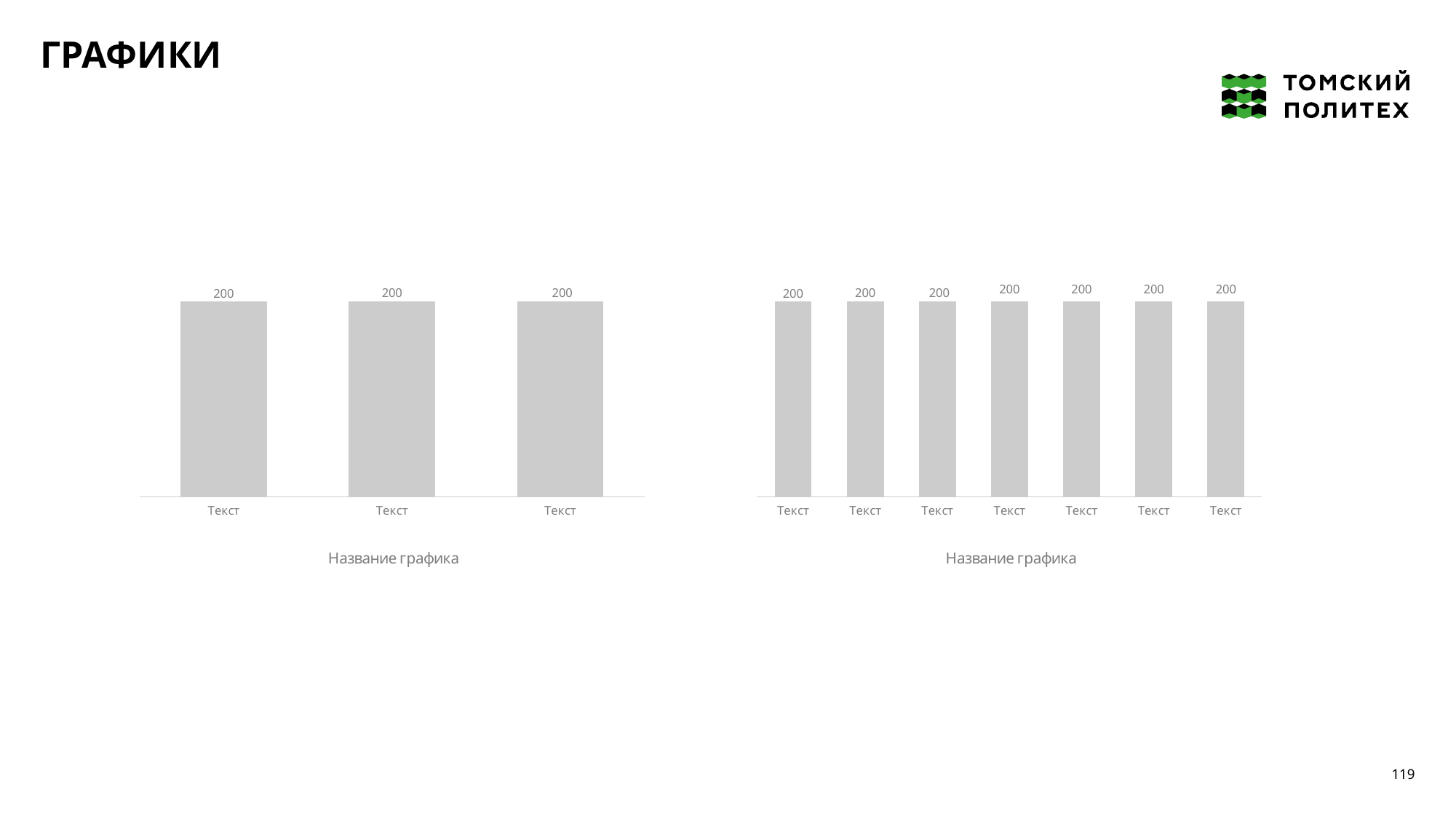
In the chart on the left side of the slide, what value is labelled on the first bar? 200 In the chart on the left side of the slide, what is the difference between the values of the first and third bars? 0 How many charts are shown on the slide? 2 What label is used for every category on the x axis of the chart on the right side of the slide? Текст What is the title shown under the chart on the left side of the slide? Название графика In the chart on the right side of the slide, what value is labelled on the last bar? 200 What kind of chart is the chart on the left side of the slide? Bar chart How many bars does the chart on the left side of the slide have? 3 In the chart on the left side of the slide, do the values rise, fall, or stay the same from left to right? Stay the same In the chart on the right side of the slide, do the values rise, fall, or stay the same from left to right? Stay the same How many bars does the chart on the right side of the slide have? 7 What kind of chart is the chart on the right side of the slide? Bar chart